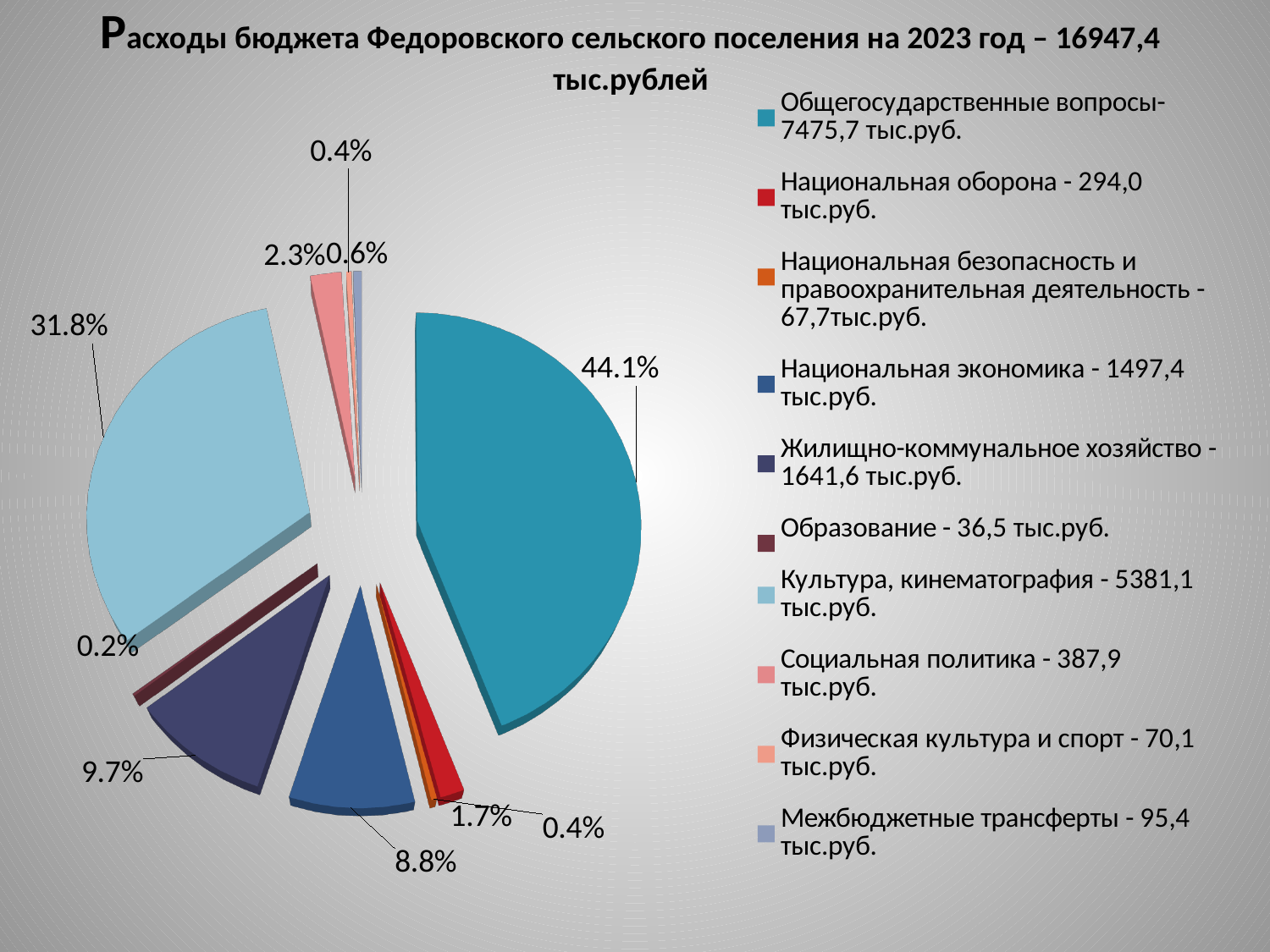
According to the legend, what is the amount for Социальная политика? 387,9 тыс.руб. What share of the pie does Культура, кинематография take? 31.8% What share of the pie does Жилищно-коммунальное хозяйство take? 9.7% What total budget expenditure amount is stated in the chart title? 16947,4 тыс.рублей According to the legend, what is the amount for Национальная экономика? 1497,4 тыс.руб. Which slice is larger: Национальная экономика or Жилищно-коммунальное хозяйство? Жилищно-коммунальное хозяйство What is the difference in percentage points between the Общегосударственные вопросы slice (44.1%) and the Культура, кинематография slice (31.8%)? 12.3 percentage points What share of the pie does Общегосударственные вопросы take? 44.1% Which category has the smallest slice of the pie? Образование What kind of chart is shown on the slide? Pie chart Which category has the largest slice of the pie? Общегосударственные вопросы How many slices (categories) does the pie chart have? 10